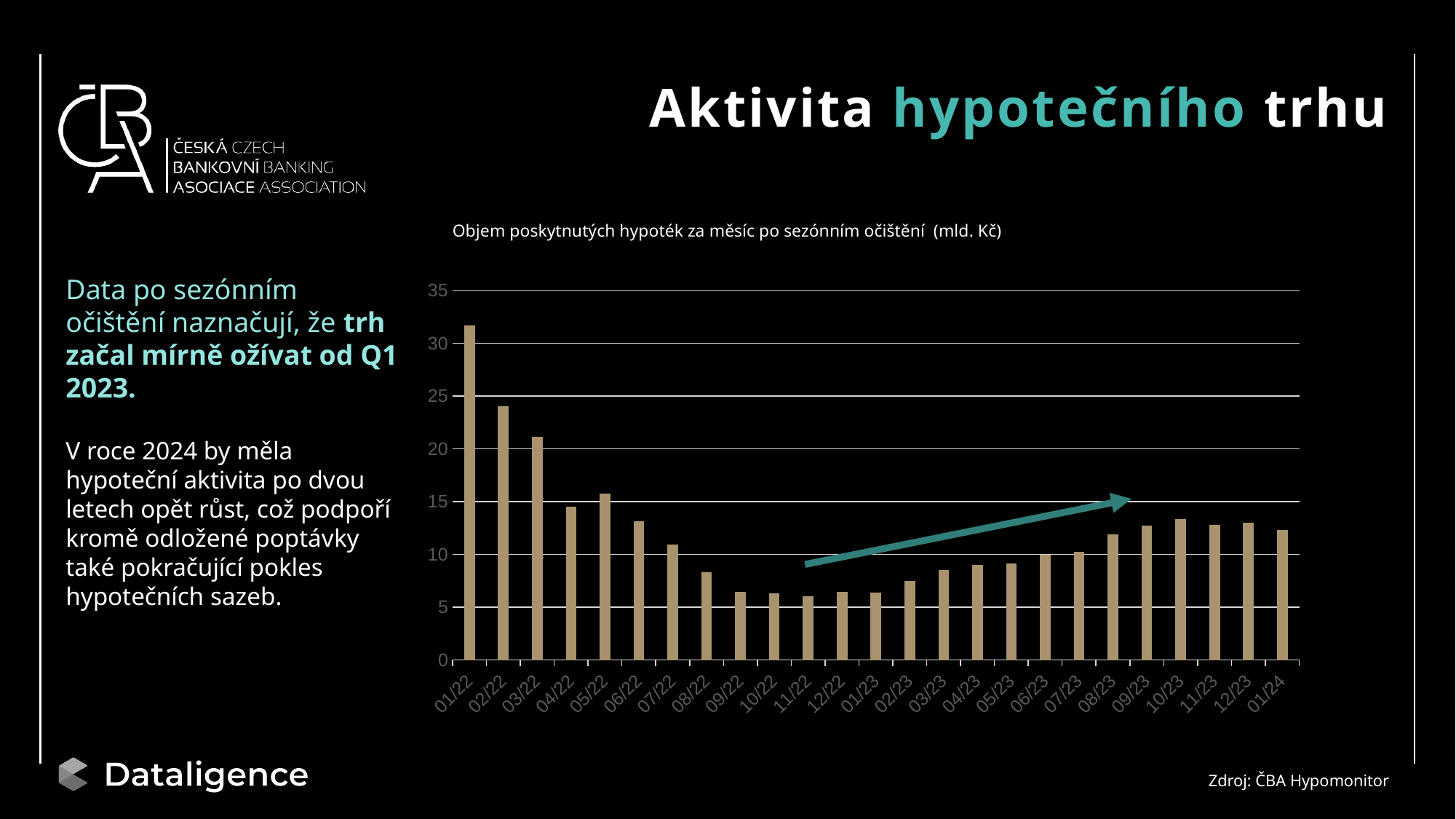
Do the values rise or fall from 01/22 to 11/22? fall What kind of chart is shown on the slide? bar chart Is the value for 03/22 greater or less than 20? greater Which month has the highest value in the chart? 01/22 Is the value for 02/22 greater or less than 25? less How many months (bars) are plotted in the chart? 25 Is the value for 10/23 greater or less than 10? greater Which is larger, the value for 02/23 or the value for 08/23? 08/23 Which is larger, the value for 02/22 or the value for 03/22? 02/22 What is the title of the chart? Objem poskytnutých hypoték za měsíc po sezónním očištění (mld. Kč)